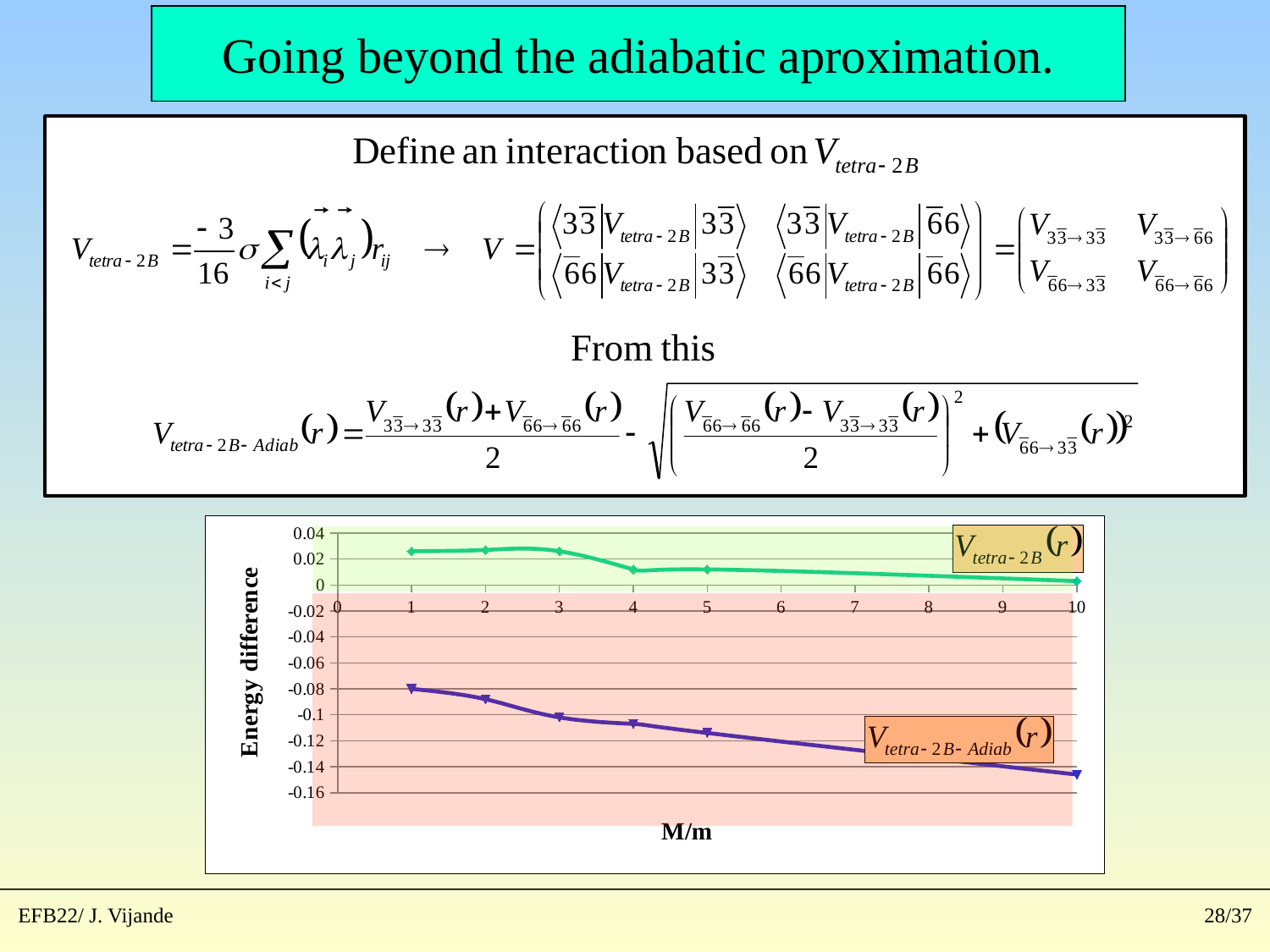
How many series are plotted in the chart? 2 What is the label of the y axis of the chart? Energy difference Does the V_tetra-2B-Adiab(r) series rise or fall as M/m increases? fall Is the value of V_tetra-2B-Adiab(r) at M/m = 2 greater or less than -0.1? greater Is the value of V_tetra-2B(r) at M/m = 4 greater or less than 0.02? less At which M/m value does the V_tetra-2B-Adiab(r) series reach its highest value? 1 At which M/m value does the V_tetra-2B-Adiab(r) series reach its lowest value? 10 How many data points are plotted for the V_tetra-2B-Adiab(r) series? 6 At M/m = 5, which series has the larger value, V_tetra-2B(r) or V_tetra-2B-Adiab(r)? V_tetra-2B(r) What kind of chart is shown on the slide? line chart What is the label of the x axis of the chart? M/m Is the value of V_tetra-2B-Adiab(r) at M/m = 5 greater or less than -0.1? less